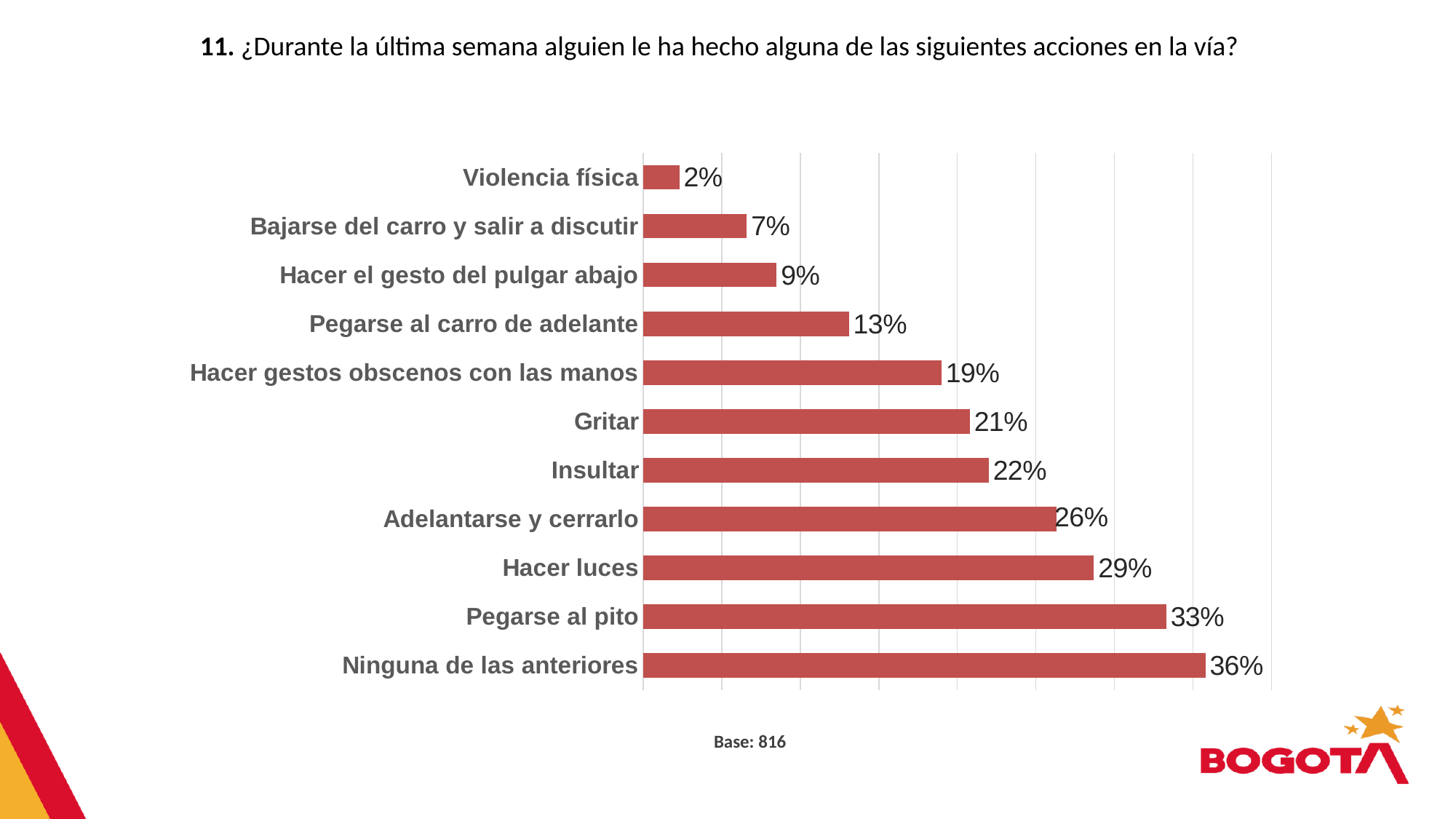
How many categories are shown in the chart? 11 What is the difference between "Ninguna de las anteriores" and "Pegarse al pito"? 3% What is the value for "Violencia física"? 2% Which category has the lowest value? Violencia física What kind of chart is shown on the slide? Bar chart What is the value for "Hacer gestos obscenos con las manos"? 19% What is the value for "Bajarse del carro y salir a discutir"? 7% What base (number of respondents) is stated below the chart? 816 Which category has the highest value? Ninguna de las anteriores What is the difference between "Hacer luces" and "Adelantarse y cerrarlo"? 3% What is the value for "Pegarse al pito"? 33% Which is larger, "Gritar" or "Pegarse al carro de adelante"? Gritar